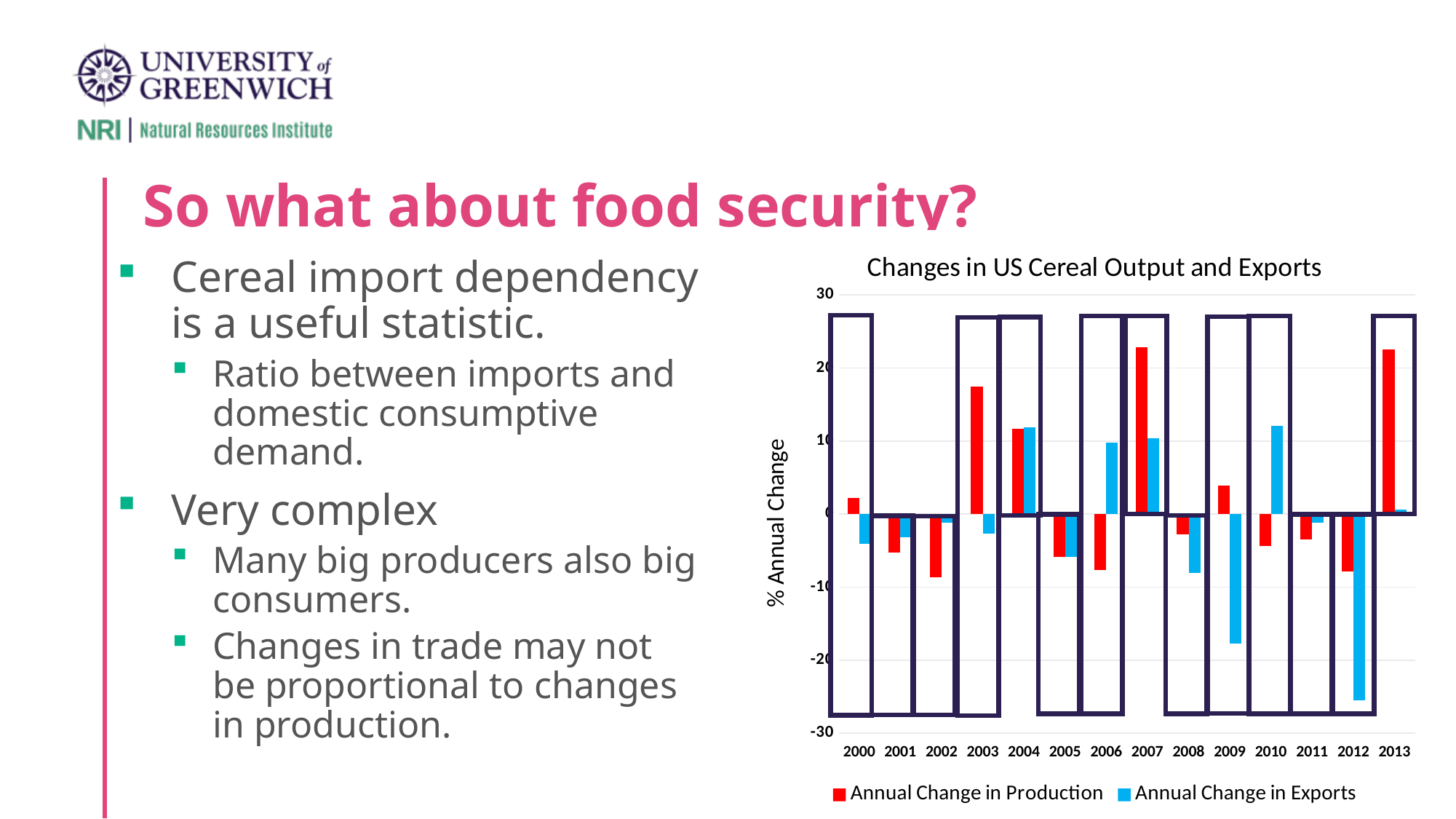
Which is larger, the Annual Change in Production for 2003 or for 2004? 2003 How many series does the chart's legend list? 2 Is the Annual Change in Production for 2003 greater or less than 10? greater Which colour represents Annual Change in Exports in the chart? Blue What is the title of the chart? Changes in US Cereal Output and Exports What kind of chart is shown on the slide? Bar chart Is the Annual Change in Exports for 2012 greater or less than -20? less How many years are shown on the x axis of the chart? 14 Is the Annual Change in Production for 2013 greater or less than 20? greater For 2013, which is larger, the Annual Change in Production or the Annual Change in Exports? Annual Change in Production In which year is the Annual Change in Exports lowest? 2012